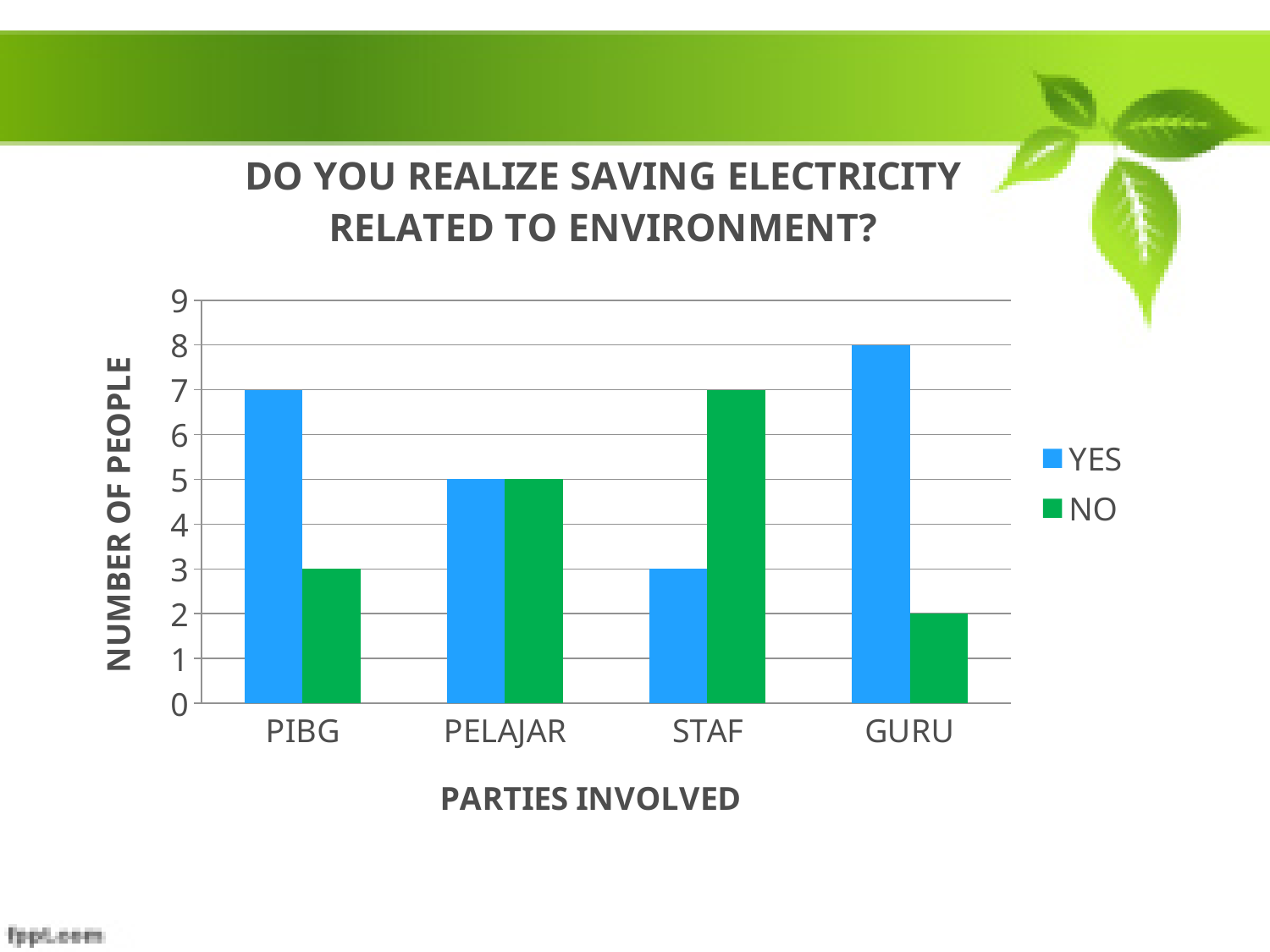
Which category has the highest YES value? GURU For STAF, which is larger, the YES value or the NO value? NO Is the NO value for PELAJAR greater or less than 4? greater What is the YES value for GURU? 8 Which category has the lowest NO value? GURU How many series does the legend list? 2 How many categories are shown on the x axis? 4 What is the NO value for STAF? 7 What type of chart is shown on the slide? Bar chart What is the YES value for PIBG? 7 What is the title of the x axis? PARTIES INVOLVED What is the difference between the YES and NO values for PIBG? 4